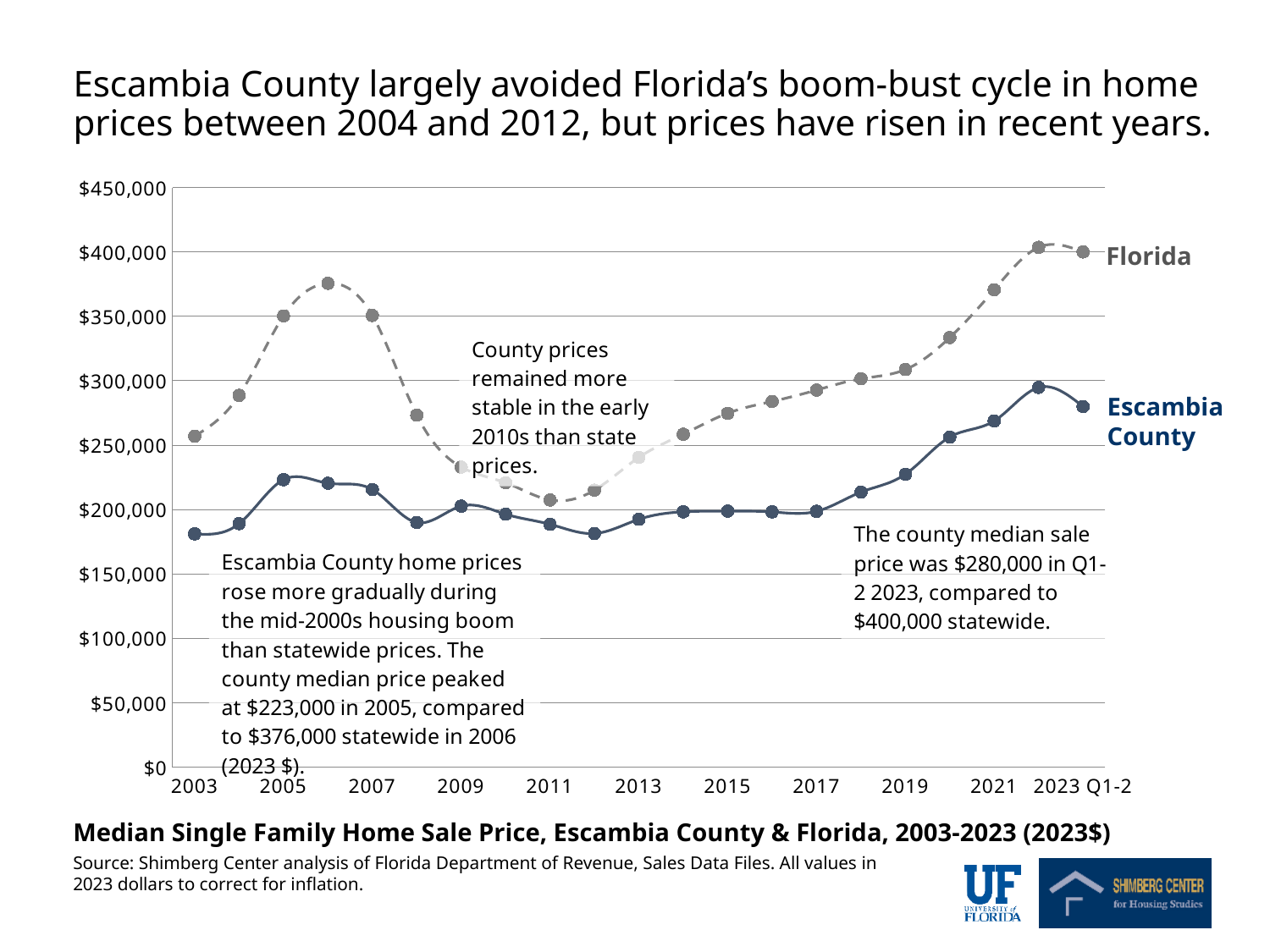
Is the Florida value for 2020 greater or less than $300,000? greater What are the names of the two series plotted on the chart? Florida and Escambia County Is the Escambia County value for 2003 greater or less than $200,000? less How many series are plotted on the chart? 2 What is the title of the chart? Median Single Family Home Sale Price, Escambia County & Florida, 2003-2023 (2023$) According to the annotation, what was the statewide median price in 2006? $376,000 According to the annotation, what was the Escambia County median sale price in Q1-2 2023? $280,000 What is the difference between the statewide median price and the Escambia County median price in Q1-2 2023, as stated on the slide? $120,000 Does the Florida series rise or fall between 2006 and 2011? fall According to the annotation, what was the peak Escambia County median price in 2005? $223,000 What kind of chart is shown on the slide? line chart In 2006, which series has the higher value, Florida or Escambia County? Florida